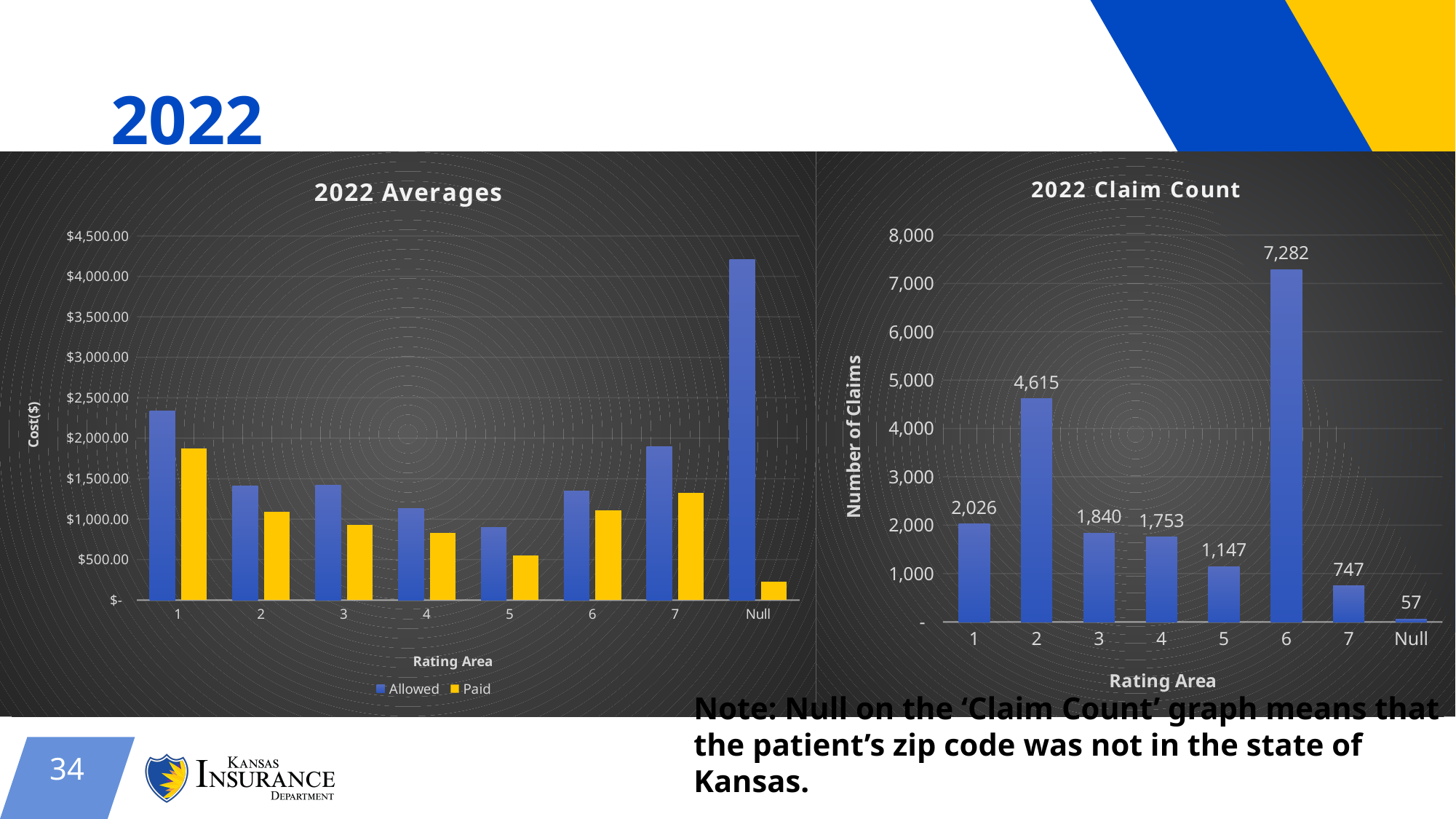
In the '2022 Claim Count' chart, what is the number of claims for the Null rating area? 57 In the '2022 Claim Count' chart, which has more claims, rating area 3 or rating area 4? 3 How many series does the legend of the '2022 Averages' chart list? 2 In the '2022 Claim Count' chart, which rating area has the highest number of claims? 6 In the '2022 Claim Count' chart, how many rating area categories are shown on the x axis? 8 In the '2022 Claim Count' chart, what is the number of claims for rating area 2? 4,615 In the '2022 Averages' chart, which rating area has the highest Allowed average cost? Null In the '2022 Claim Count' chart, which rating area has the lowest number of claims? Null In the '2022 Averages' chart, is the Allowed value for rating area 1 greater or less than $2,000.00? greater In the '2022 Claim Count' chart, what is the number of claims for rating area 6? 7,282 In the '2022 Averages' chart, is the Paid value for rating area 5 greater or less than $1,000.00? less In the '2022 Claim Count' chart, what is the difference in claims between rating area 6 and rating area 2? 2,667